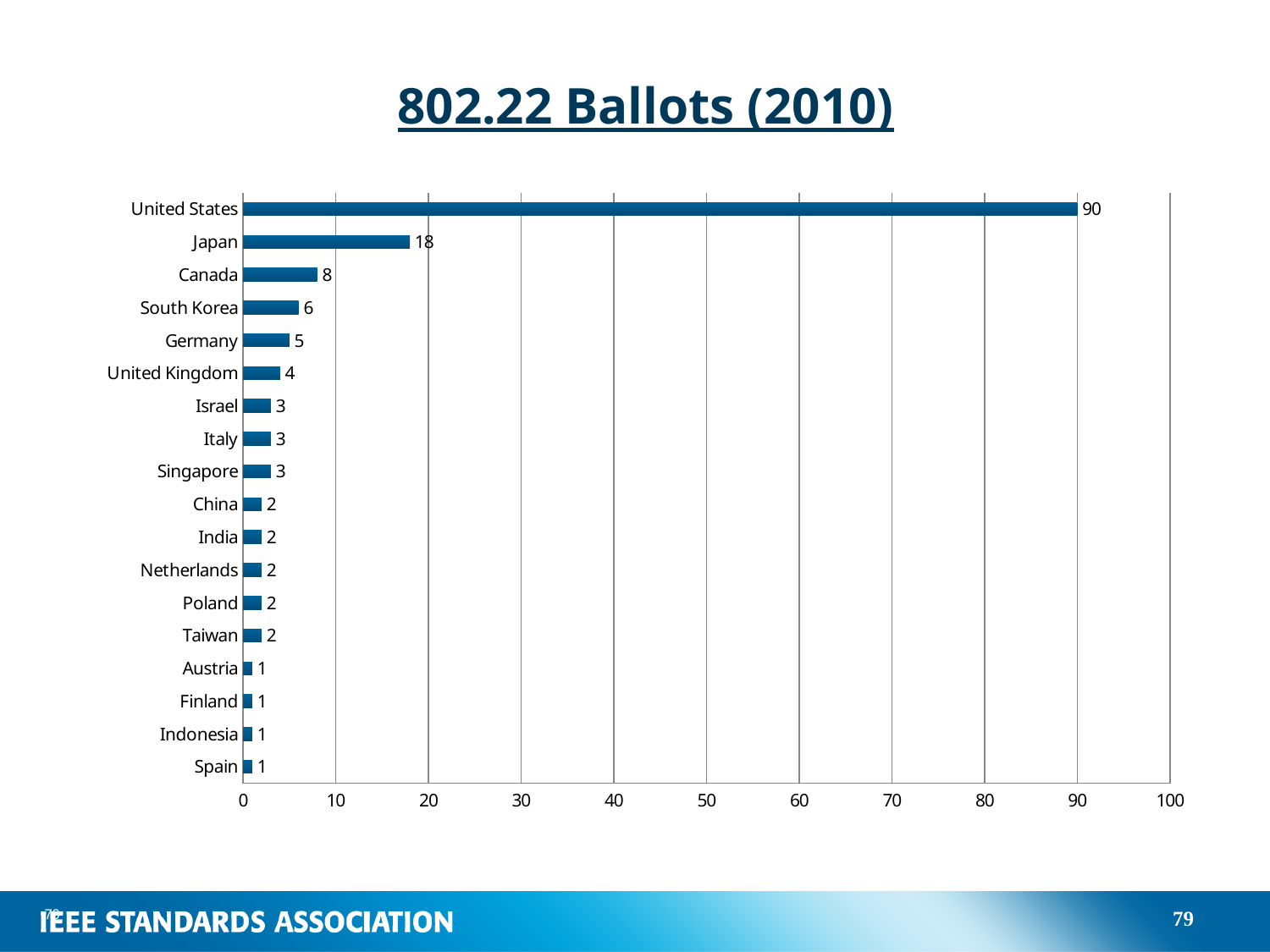
How many countries have a value of 1? 4 What kind of chart is shown on the slide? bar chart Which country has the highest number of ballots? United States What is the value for United Kingdom? 4 What is the difference between the values for United States and Japan? 72 What is the value for Canada? 8 Which is larger, the value for Canada or the value for South Korea? Canada How many countries are shown in the chart? 18 What is the title of the chart? 802.22 Ballots (2010) What is the value for Japan? 18 What is the difference between the values for South Korea and Germany? 1 Is the value for United States greater or less than 80? greater